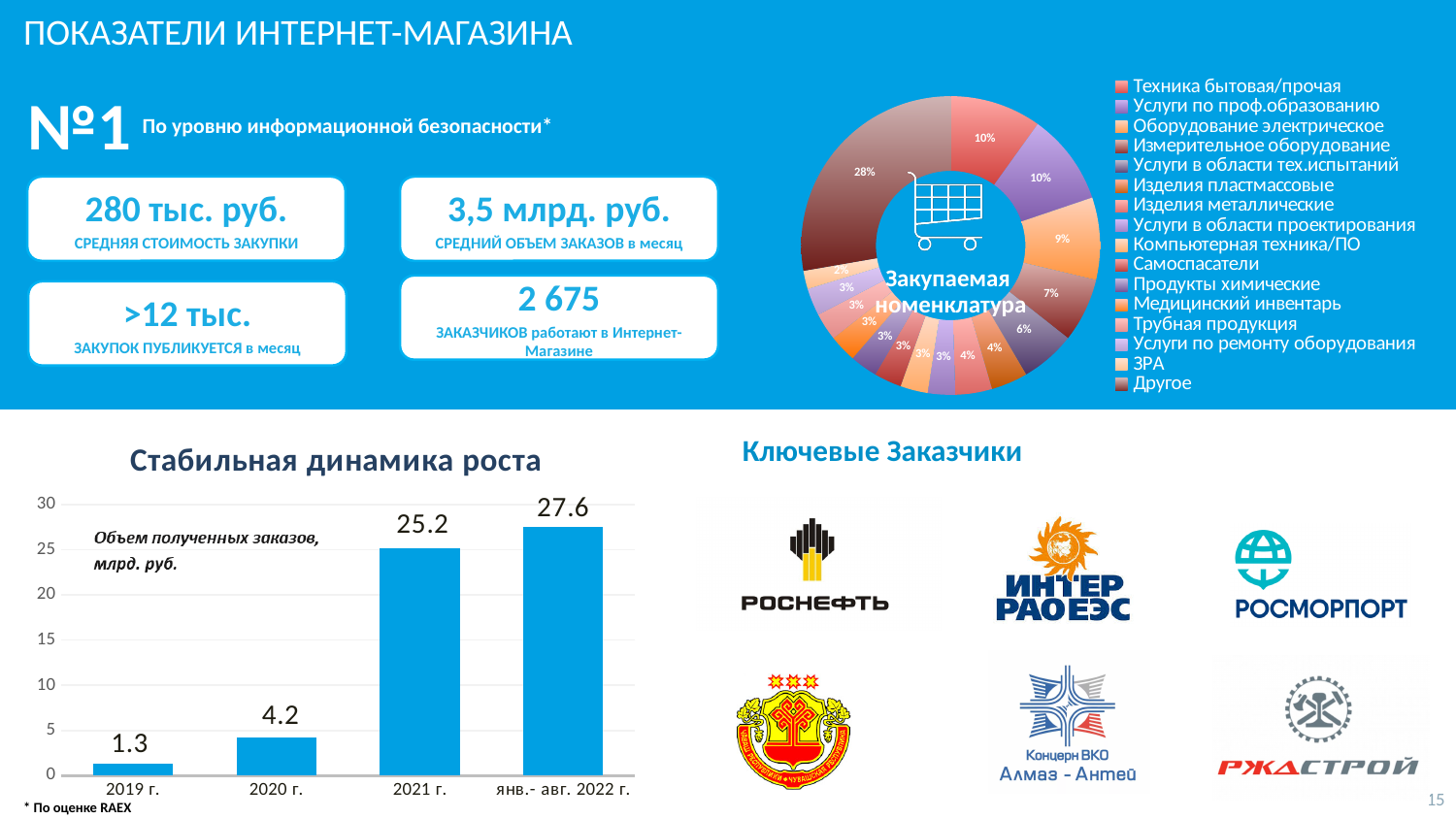
On the bar chart 'Стабильная динамика роста', how many categories are shown on the x axis? 4 On the bar chart 'Стабильная динамика роста', which is larger: the value for 2020 г. or the value for 2019 г.? 2020 г. On the chart 'Закупаемая номенклатура', what is the percentage of the largest slice? 28% On the bar chart 'Стабильная динамика роста', what is the value for янв.- авг. 2022 г.? 27.6 On the bar chart 'Стабильная динамика роста', what is the value for 2021 г.? 25.2 On the bar chart 'Стабильная динамика роста', what is the value for 2019 г.? 1.3 What kind of chart is 'Закупаемая номенклатура'? pie chart (donut) What kind of chart is 'Стабильная динамика роста'? bar chart On the bar chart 'Стабильная динамика роста', which category has the highest value? янв.- авг. 2022 г. On the bar chart 'Стабильная динамика роста', which category has the lowest value? 2019 г. On the bar chart 'Стабильная динамика роста', what is the difference between the values for 2021 г. and 2020 г.? 21.0 On the bar chart 'Стабильная динамика роста', do the values rise or fall from 2019 г. to янв.- авг. 2022 г.? rise